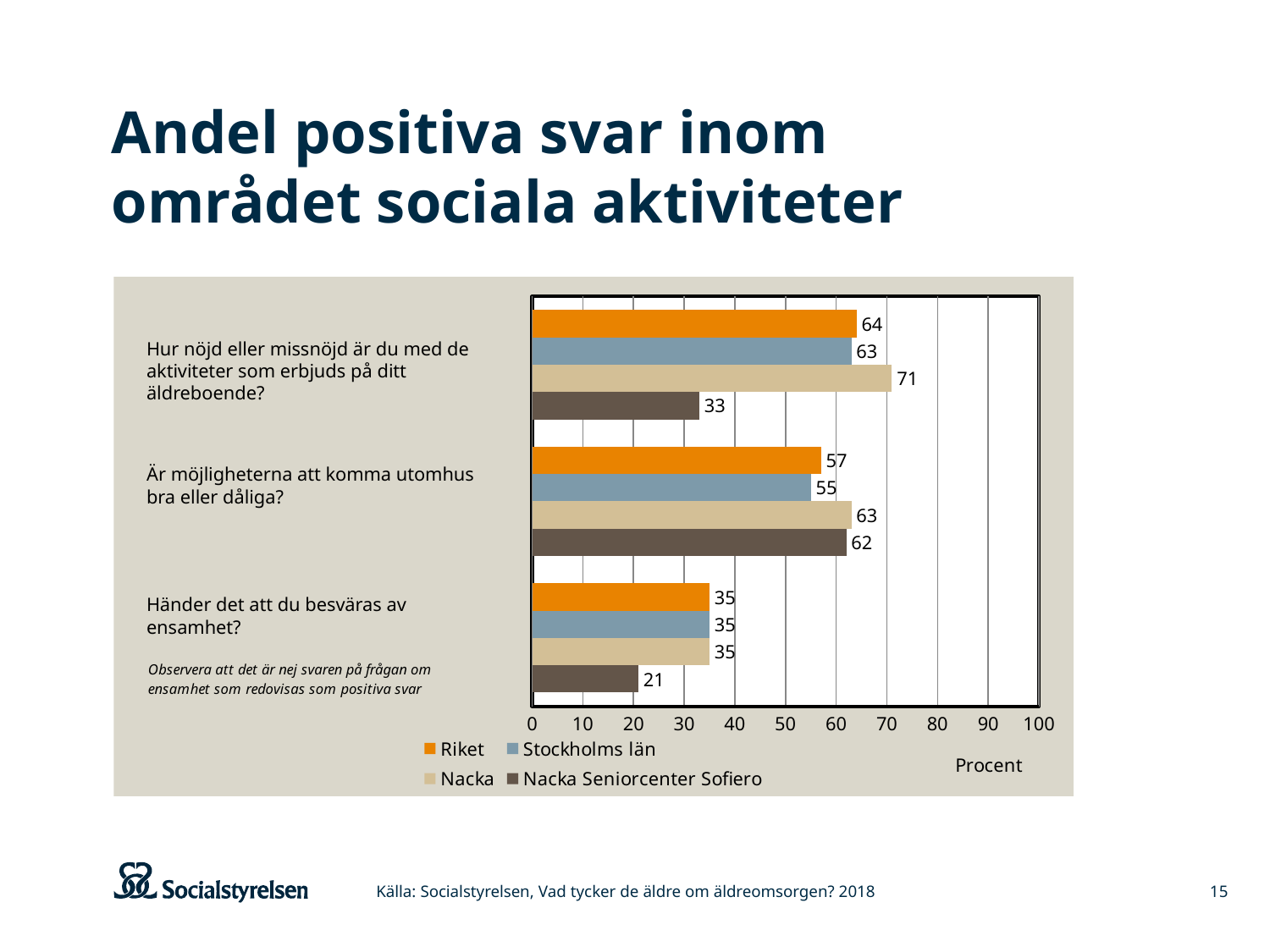
What is the value for Nacka Seniorcenter Sofiero on the question "Är möjligheterna att komma utomhus bra eller dåliga?"? 62 Is the value for Nacka Seniorcenter Sofiero on the question "Händer det att du besväras av ensamhet?" greater or less than 30? less Which series has the highest value on the question "Är möjligheterna att komma utomhus bra eller dåliga?"? Nacka What is the label of the horizontal axis? Procent What is the value for Nacka on the question "Hur nöjd eller missnöjd är du med de aktiviteter som erbjuds på ditt äldreboende?"? 71 What is the difference between the Nacka value and the Nacka Seniorcenter Sofiero value on the question "Hur nöjd eller missnöjd är du med de aktiviteter som erbjuds på ditt äldreboende?"? 38 Which series has the lowest value on the question "Hur nöjd eller missnöjd är du med de aktiviteter som erbjuds på ditt äldreboende?"? Nacka Seniorcenter Sofiero How many questions (categories) are shown on the chart? 3 Which is larger on the question "Är möjligheterna att komma utomhus bra eller dåliga?": the value for Riket or for Stockholms län? Riket What is the value for Riket on the question "Händer det att du besväras av ensamhet?"? 35 How many series does the legend list? 4 What kind of chart is shown on the slide? bar chart